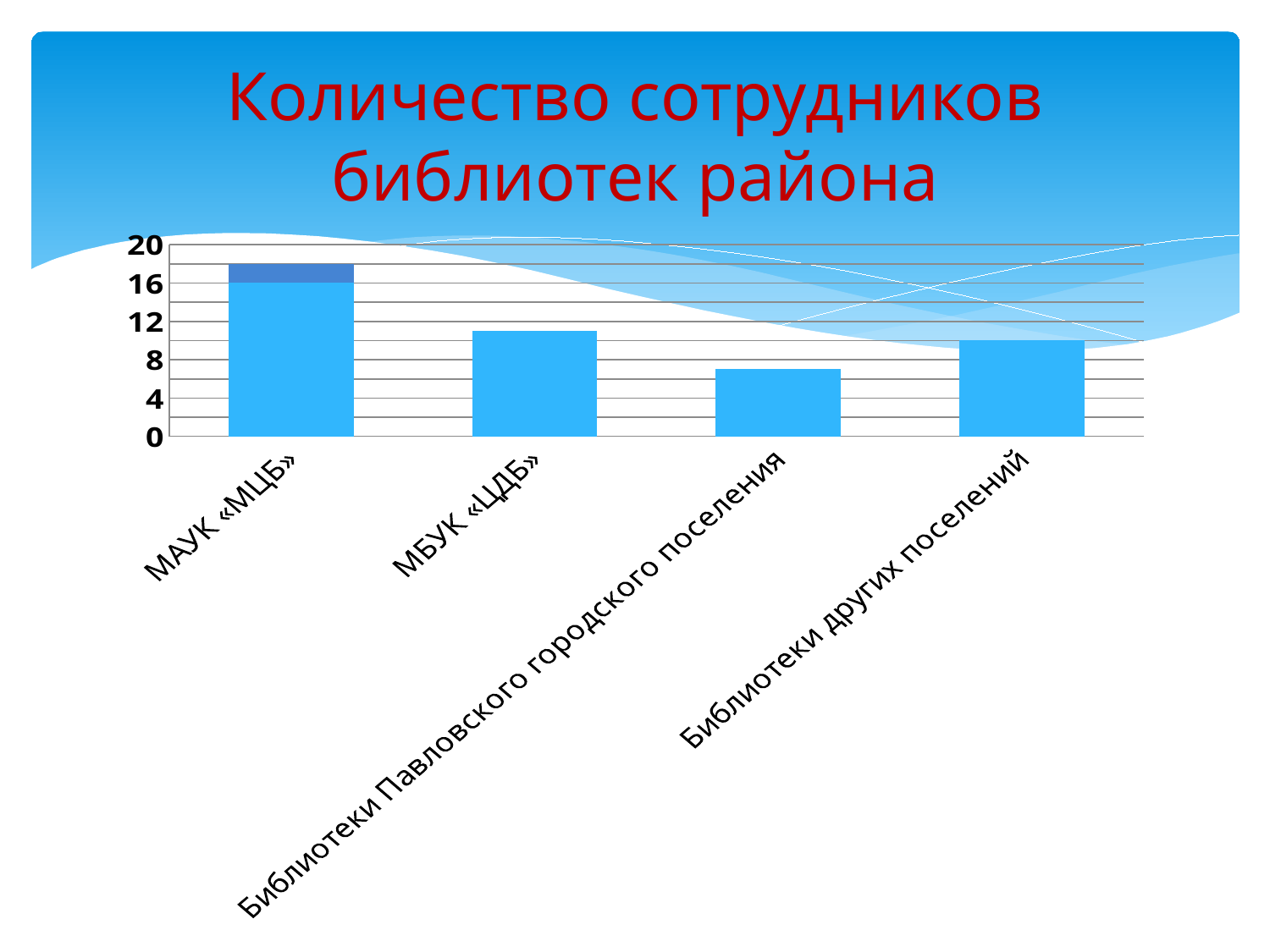
Which is larger, the value for МАУК «МЦБ» or the value for МБУК «ЦДБ»? МАУК «МЦБ» Which is larger, the value for Библиотеки Павловского городского поселения or the value for Библиотеки других поселений? Библиотеки других поселений What kind of chart is shown on the slide? bar chart Which category has the lowest value? Библиотеки Павловского городского поселения Is the value for Библиотеки других поселений greater or less than 12? less Is the value for МАУК «МЦБ» greater or less than 16? greater Is the value for Библиотеки Павловского городского поселения greater or less than 8? less What is the title of the chart? Количество сотрудников библиотек района Which category has the highest value? МАУК «МЦБ» What is the highest value shown on the vertical axis? 20 How many categories are shown on the x axis? 4